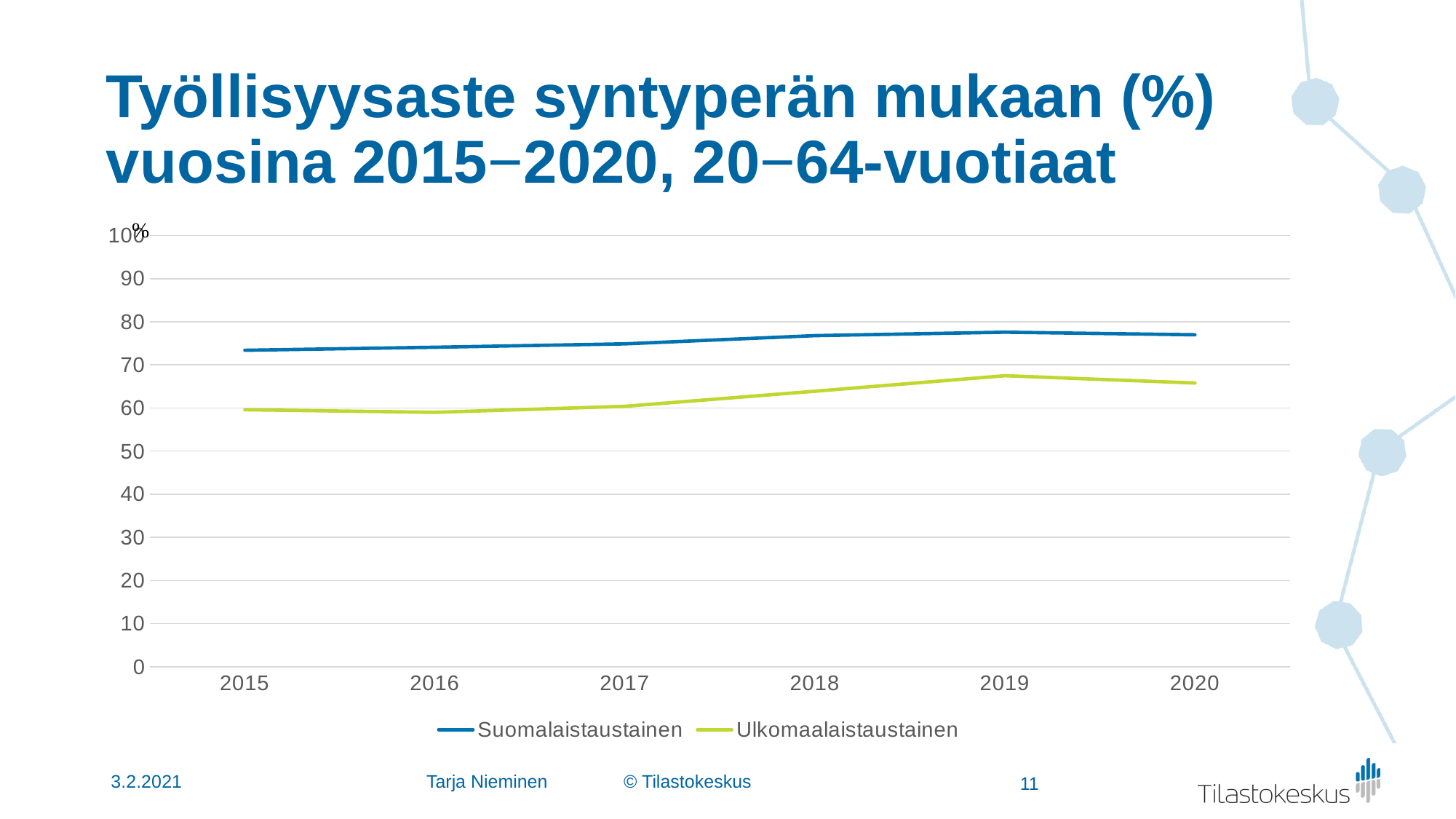
In which year does the Ulkomaalaistaustainen series reach its highest value? 2019 How many years are plotted along the x axis? 6 Which series is plotted with the blue line? Suomalaistaustainen Does the Ulkomaalaistaustainen series rise or fall from 2016 to 2019? rise What is the title of the chart on the slide? Työllisyysaste syntyperän mukaan (%) vuosina 2015−2020, 20−64-vuotiaat What kind of chart is shown on the slide? line chart Is the value for Suomalaistaustainen in 2020 greater or less than 80? less Is the value for Suomalaistaustainen in 2015 greater or less than 70? greater Is the value for Ulkomaalaistaustainen in 2019 greater or less than 60? greater In 2018, which series has the higher value, Suomalaistaustainen or Ulkomaalaistaustainen? Suomalaistaustainen How many series does the legend list? 2